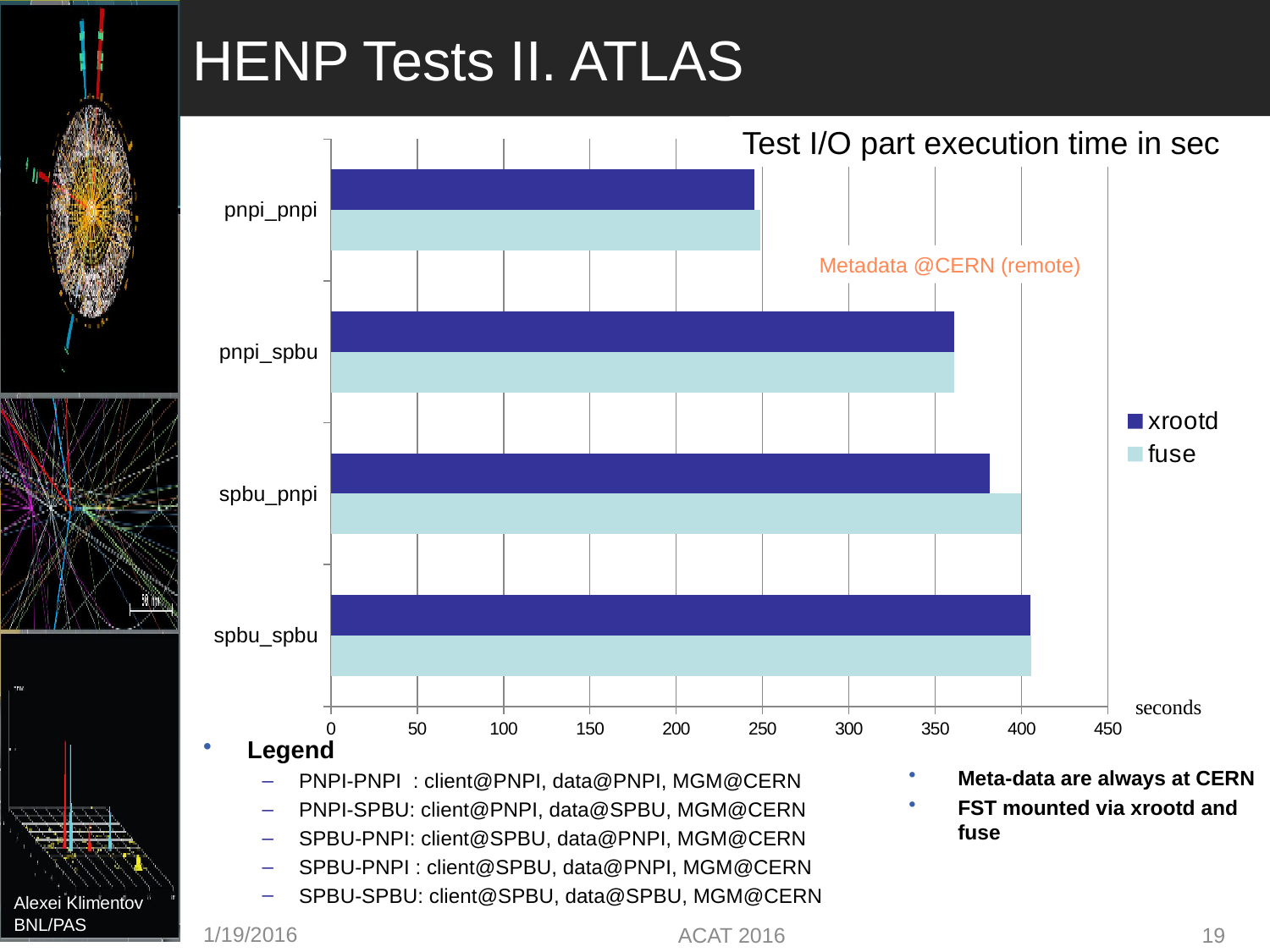
What is the title of the chart? Test I/O part execution time in sec What kind of chart is shown on the slide? bar chart How many series does the chart legend list? 2 Which category has the lowest fuse execution time? pnpi_pnpi What are the two series named in the chart legend? xrootd and fuse Which is larger for spbu_pnpi, the xrootd value or the fuse value? fuse Which category has the larger fuse value, pnpi_pnpi or spbu_spbu? spbu_spbu Is the xrootd value for pnpi_spbu greater or less than 350? greater Is the xrootd value for pnpi_pnpi greater or less than 250? less Which category has the highest xrootd execution time? spbu_spbu Is the fuse value for spbu_spbu greater or less than 400? greater How many categories are plotted on the chart? 4